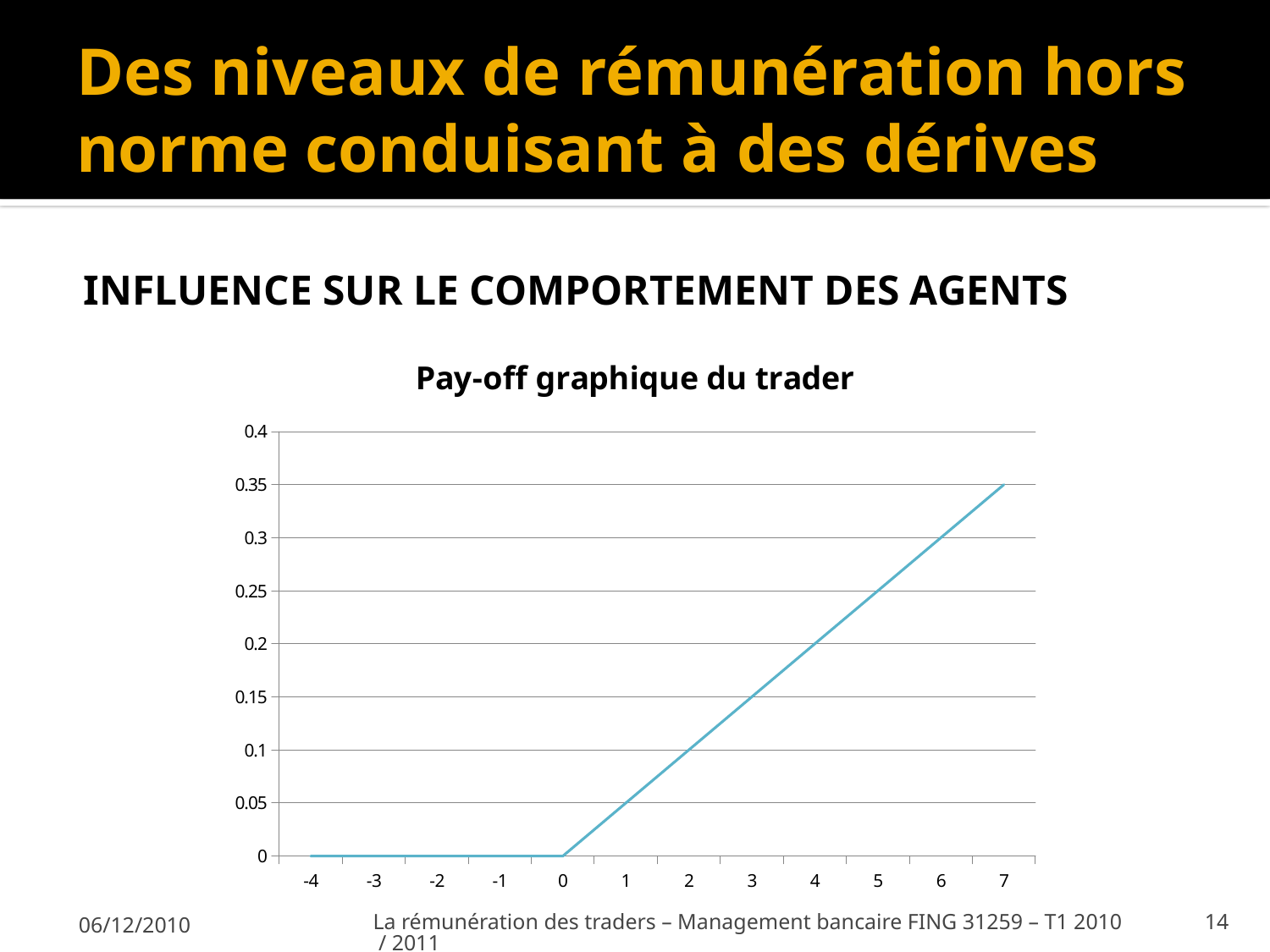
What is the value of the line at x = 2? 0.1 What kind of chart is shown on the slide? line chart Is the value of the line at x = 1 greater or less than 0.1? less What is the value of the line at x = -4? 0 Which is larger, the value at x = 5 or the value at x = 1? x = 5 What is the value of the line at x = 0? 0 At which x value does the line reach its highest point? 7 What is the value of the line at x = 7? 0.35 Does the line rise or fall between x = 0 and x = 7? rise Is the value of the line at x = 5 greater or less than 0.2? greater What is the title of the chart? Pay-off graphique du trader How many x-axis categories are shown on the chart? 12